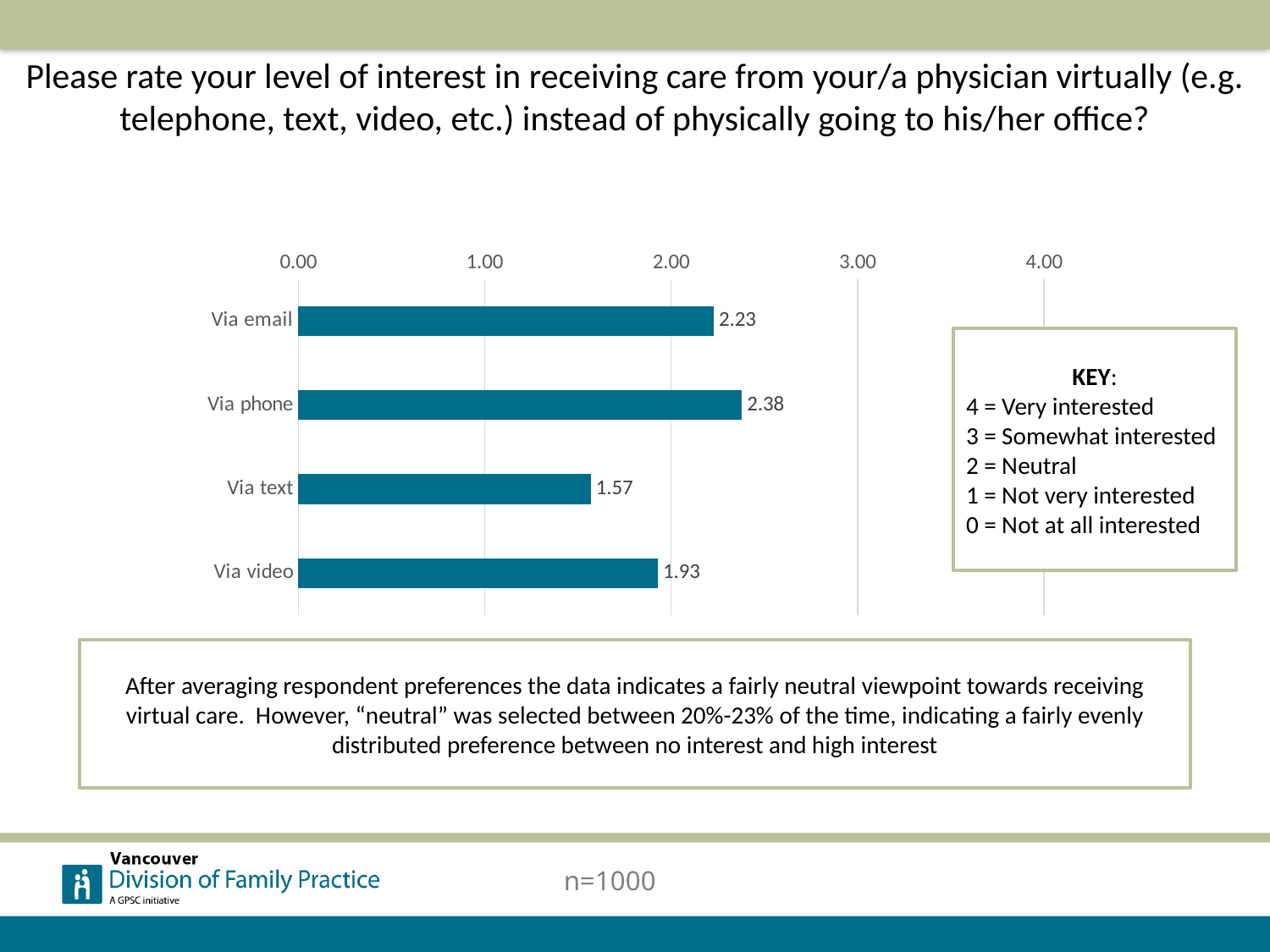
What is the average interest rating for receiving care via email? 2.23 What is the average interest rating for receiving care via phone? 2.38 How many virtual care methods are shown in the chart? 4 What is the average interest rating for receiving care via video? 1.93 What is the average interest rating for receiving care via text? 1.57 What type of chart is used on this slide? Bar chart Is the average rating for via text greater or less than 2.00? less Which method of virtual care has the lowest average interest rating? Via text Which method of virtual care has the highest average interest rating? Via phone What is the difference between the average rating for via phone and via text? 0.81 Which has a higher average interest rating, via email or via video? Via email What is the difference between the average rating for via email and via video? 0.30